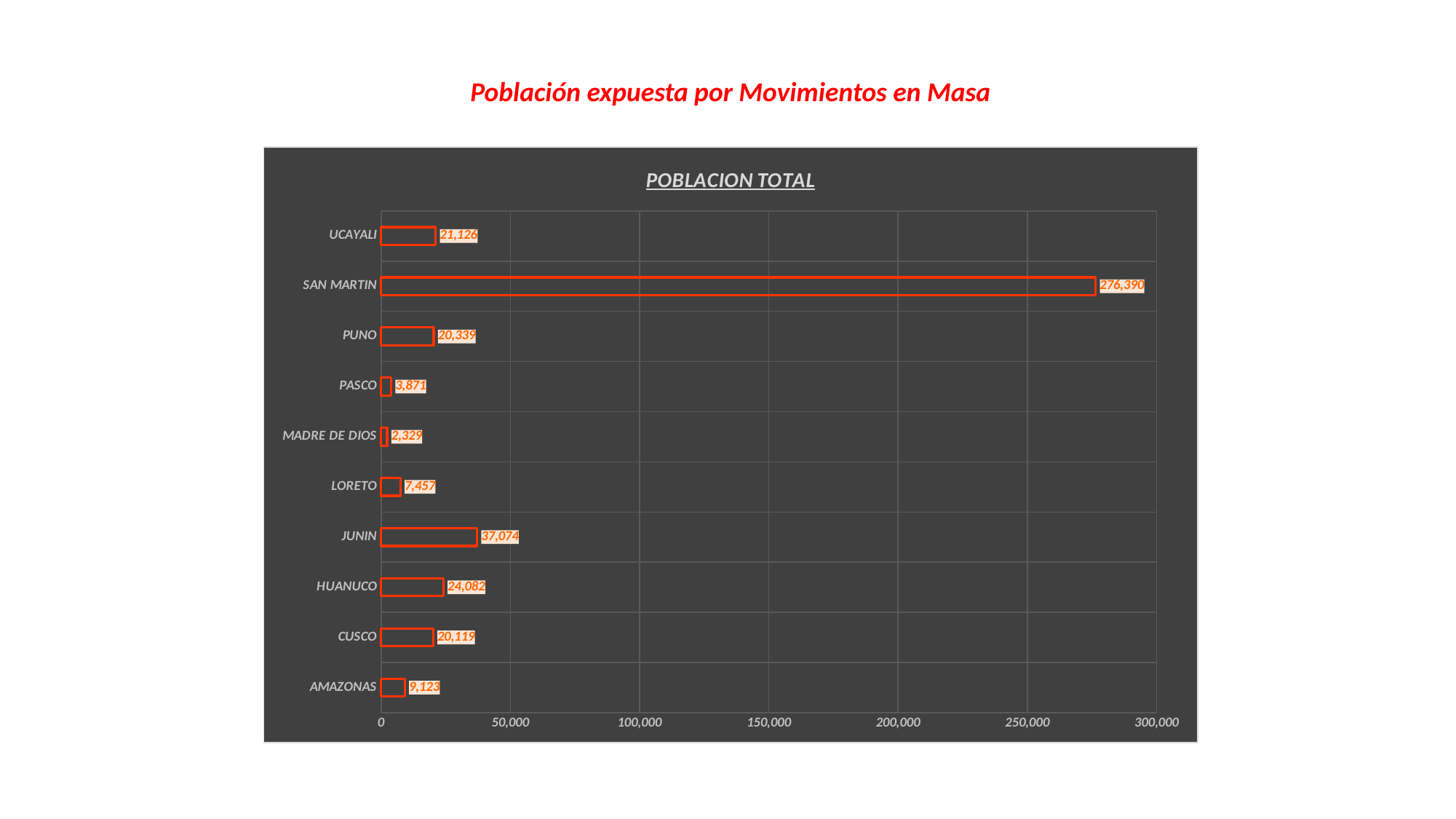
What kind of chart is shown? bar chart Which category has the highest value? SAN MARTIN What is the difference between the values for JUNIN and HUANUCO? 12,992 Which category has the lowest value? MADRE DE DIOS What is the value for SAN MARTIN? 276,390 Is the value for SAN MARTIN greater or less than 250,000? greater How many categories are shown in the chart? 10 What is the title of the chart? POBLACION TOTAL Which is larger, the value for UCAYALI or the value for PUNO? UCAYALI What is the value for JUNIN? 37,074 What is the value for MADRE DE DIOS? 2,329 What is the value for AMAZONAS? 9,123